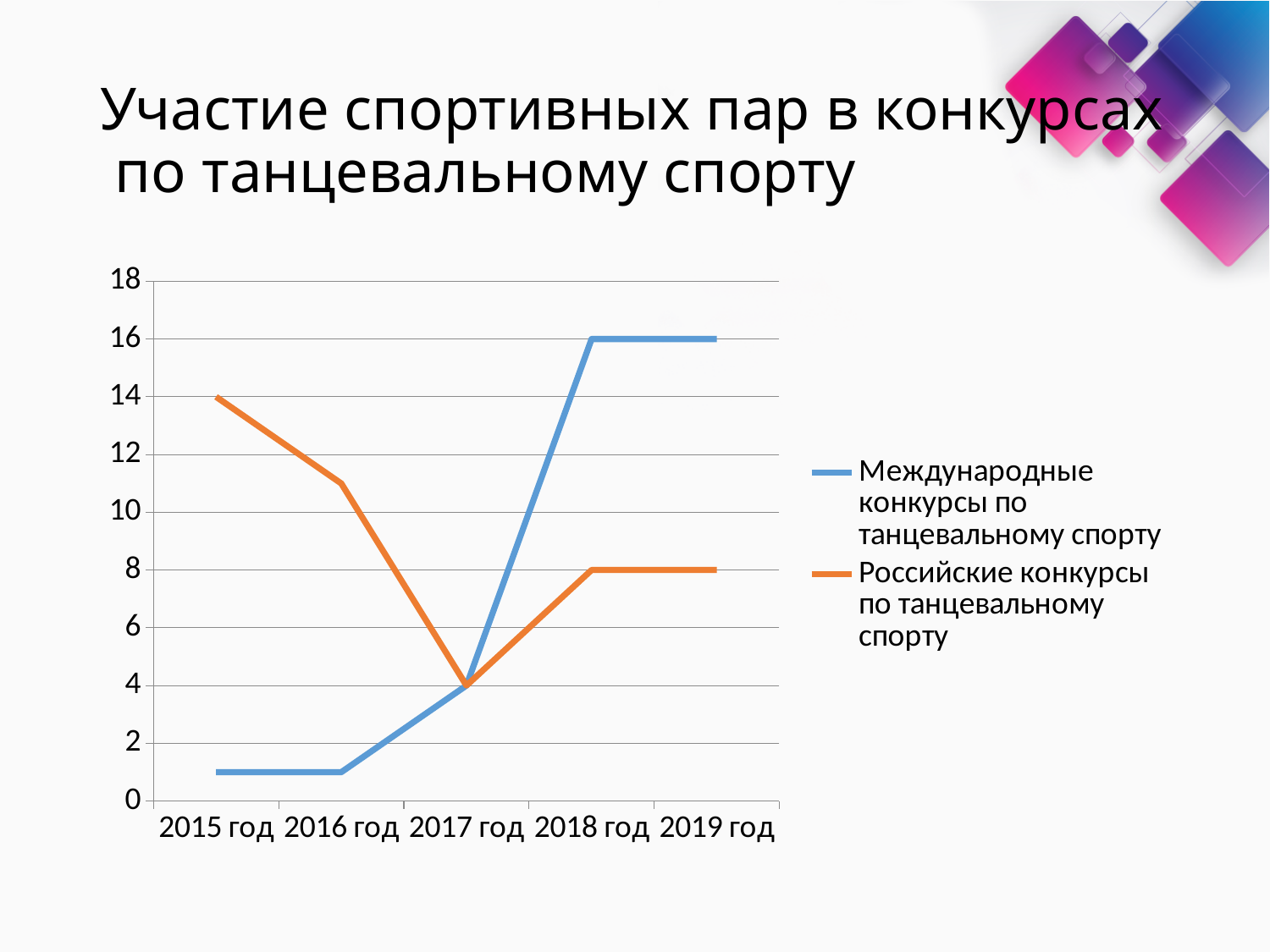
Which series has the higher value in 2015 год? Российские конкурсы по танцевальному спорту What is the value for Международные конкурсы по танцевальному спорту in 2018 год? 16 What is the value for Российские конкурсы по танцевальному спорту in 2015 год? 14 In which year does Российские конкурсы по танцевальному спорту reach its lowest value? 2017 год How many series does the legend list? 2 What is the difference between Международные конкурсы and Российские конкурсы in 2018 год? 8 Is the value for Российские конкурсы по танцевальному спорту in 2016 год greater or less than 10? greater What is the value for Международные конкурсы по танцевальному спорту in 2017 год? 4 What kind of chart is shown on the slide? line chart How many years are shown on the x axis? 5 What is the value for Российские конкурсы по танцевальному спорту in 2019 год? 8 Is the value for Международные конкурсы по танцевальному спорту in 2015 год greater or less than 2? less